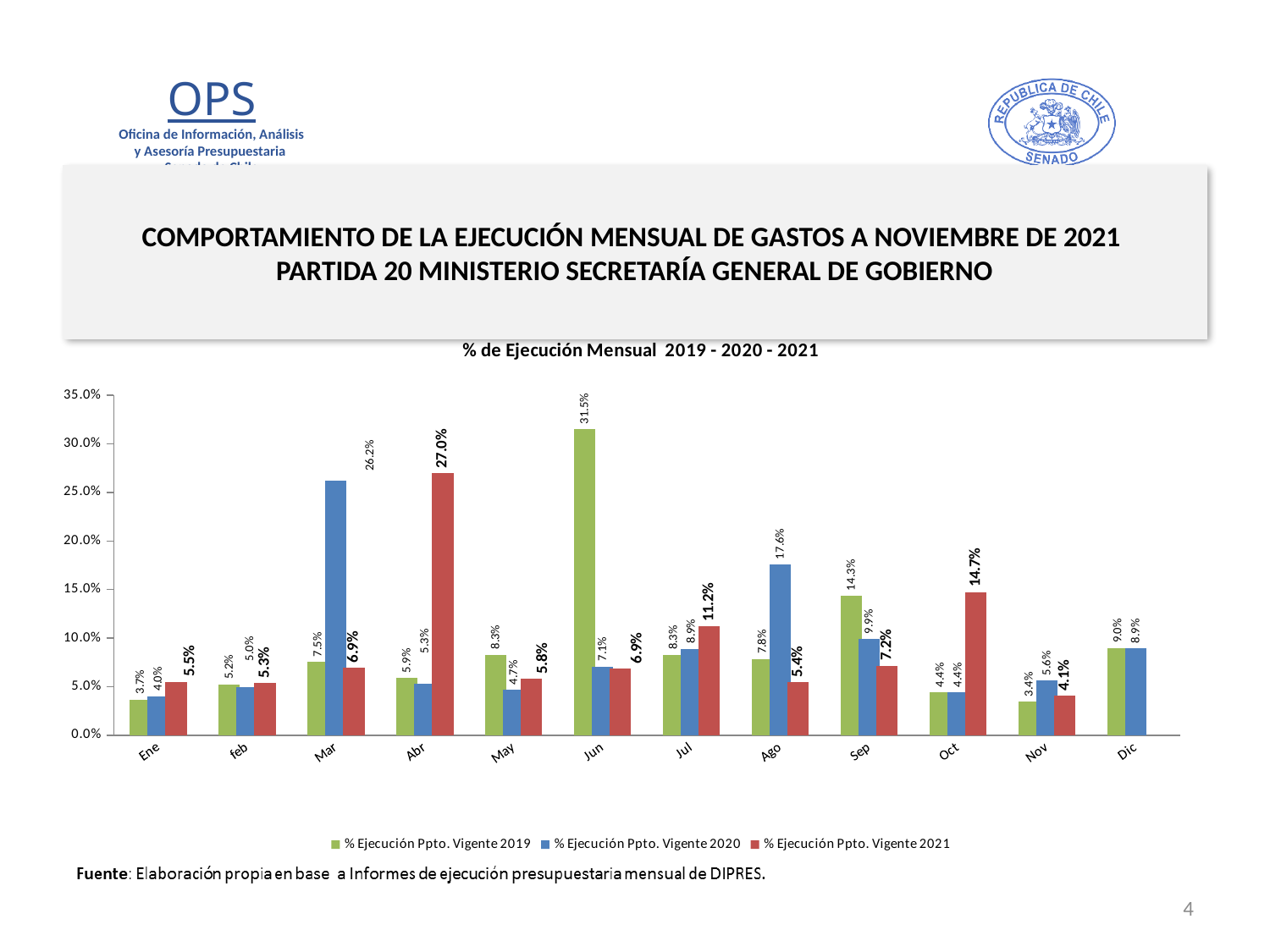
What is the title of the chart? % de Ejecución Mensual 2019 - 2020 - 2021 In Oct, which series is larger: % Ejecución Ppto. Vigente 2021 or % Ejecución Ppto. Vigente 2019? % Ejecución Ppto. Vigente 2021 How many months are shown on the x axis? 12 What is the value for % Ejecución Ppto. Vigente 2019 in Sep? 14.3% Which month has the lowest value for % Ejecución Ppto. Vigente 2021? Nov What kind of chart is shown on the slide? Bar chart What is the difference between the 2020 and 2019 values in Ago? 9.8% What is the value for % Ejecución Ppto. Vigente 2020 in Mar? 26.2% How many series does the legend list? 3 Which month has the highest value for % Ejecución Ppto. Vigente 2019? Jun Is the value for % Ejecución Ppto. Vigente 2019 in Jun greater or less than 30.0%? greater What is the value for % Ejecución Ppto. Vigente 2021 in Abr? 27.0%